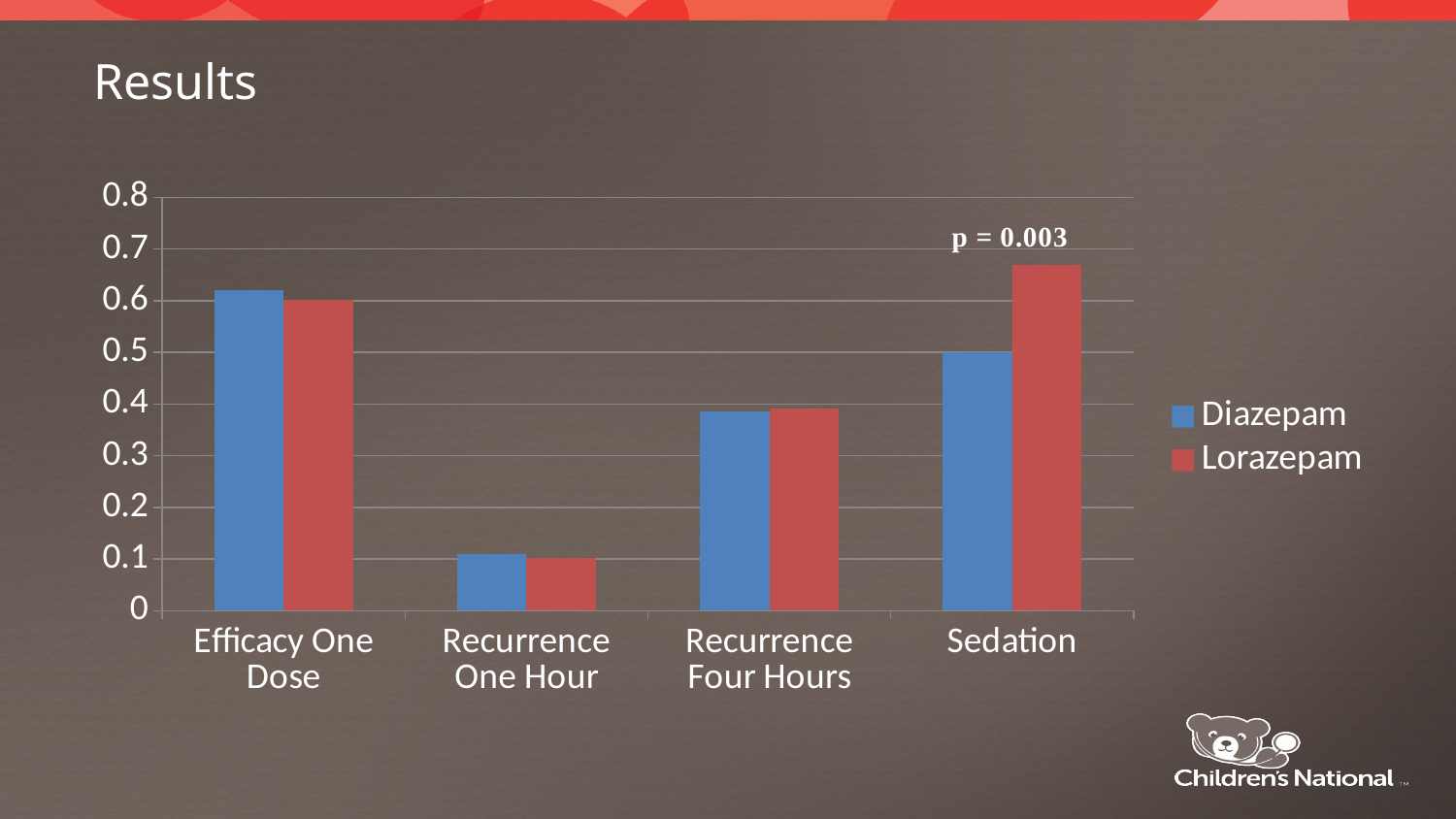
Which category has the highest Lorazepam value? Sedation Which category has the lowest Diazepam value? Recurrence One Hour Which colour represents Lorazepam in the legend? Red Is the Diazepam value for Efficacy One Dose greater or less than 0.5? greater What p-value is annotated above the Sedation bars? p = 0.003 How many series does the legend list? 2 Is the Lorazepam value for Sedation greater or less than 0.6? greater How many categories are shown on the x axis? 4 Is the Lorazepam value for Recurrence Four Hours greater or less than 0.5? less For Sedation, which is larger: Diazepam or Lorazepam? Lorazepam What kind of chart is shown on the slide? Bar chart